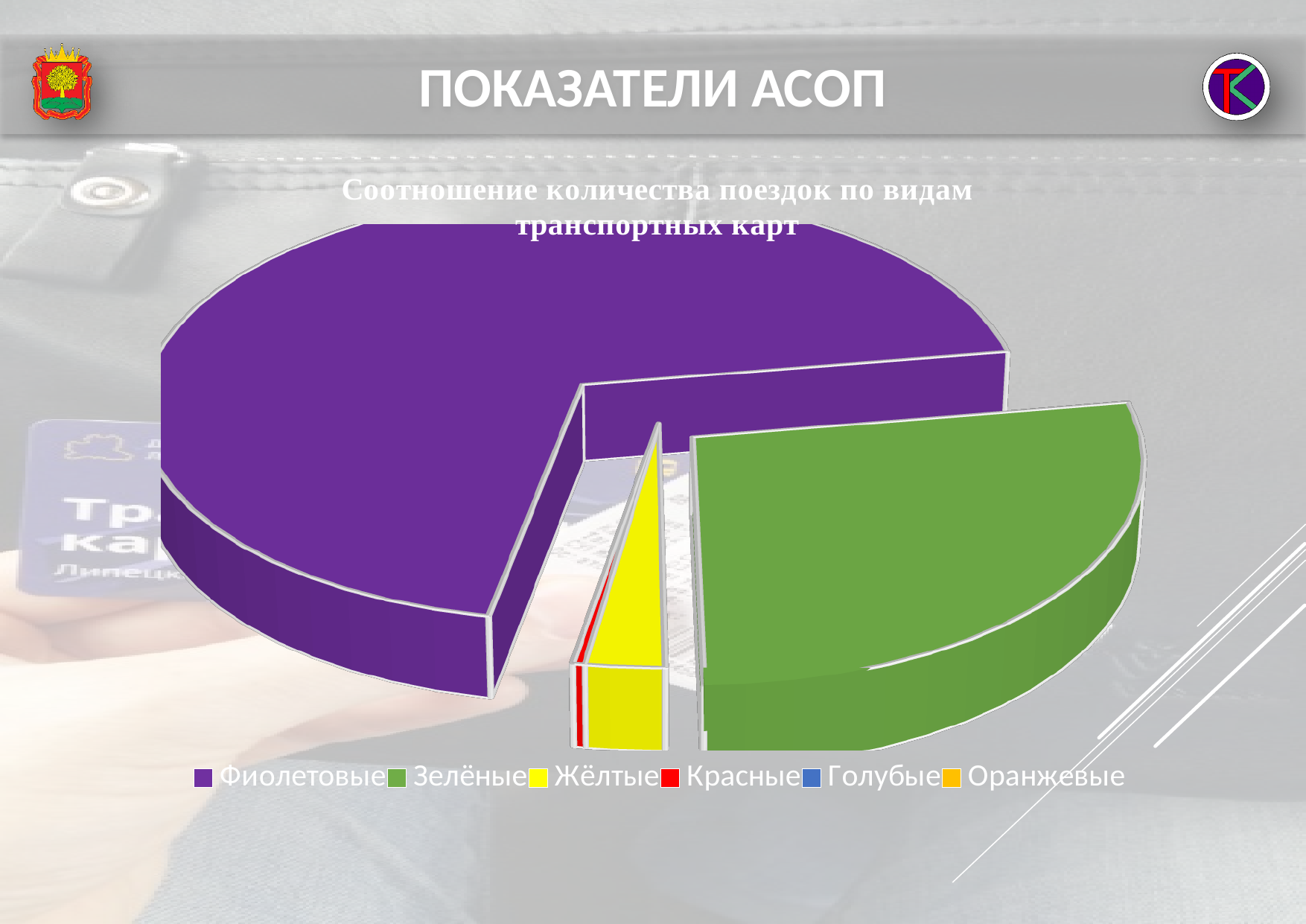
Is the Фиолетовые slice greater or less than half of the pie? greater What kind of chart is shown on the slide? Pie chart What colour represents the Зелёные category in the legend? Green Is the Зелёные slice greater or less than half of the pie? less Which slice is larger, Фиолетовые or Зелёные? Фиолетовые Which category has the second-largest slice of the pie? Зелёные How many entries does the chart legend list? 6 What is the title of the chart? Соотношение количества поездок по видам транспортных карт Which slice is larger, Зелёные or Жёлтые? Зелёные Which category has the largest slice of the pie? Фиолетовые Which slice is larger, Жёлтые or Красные? Жёлтые